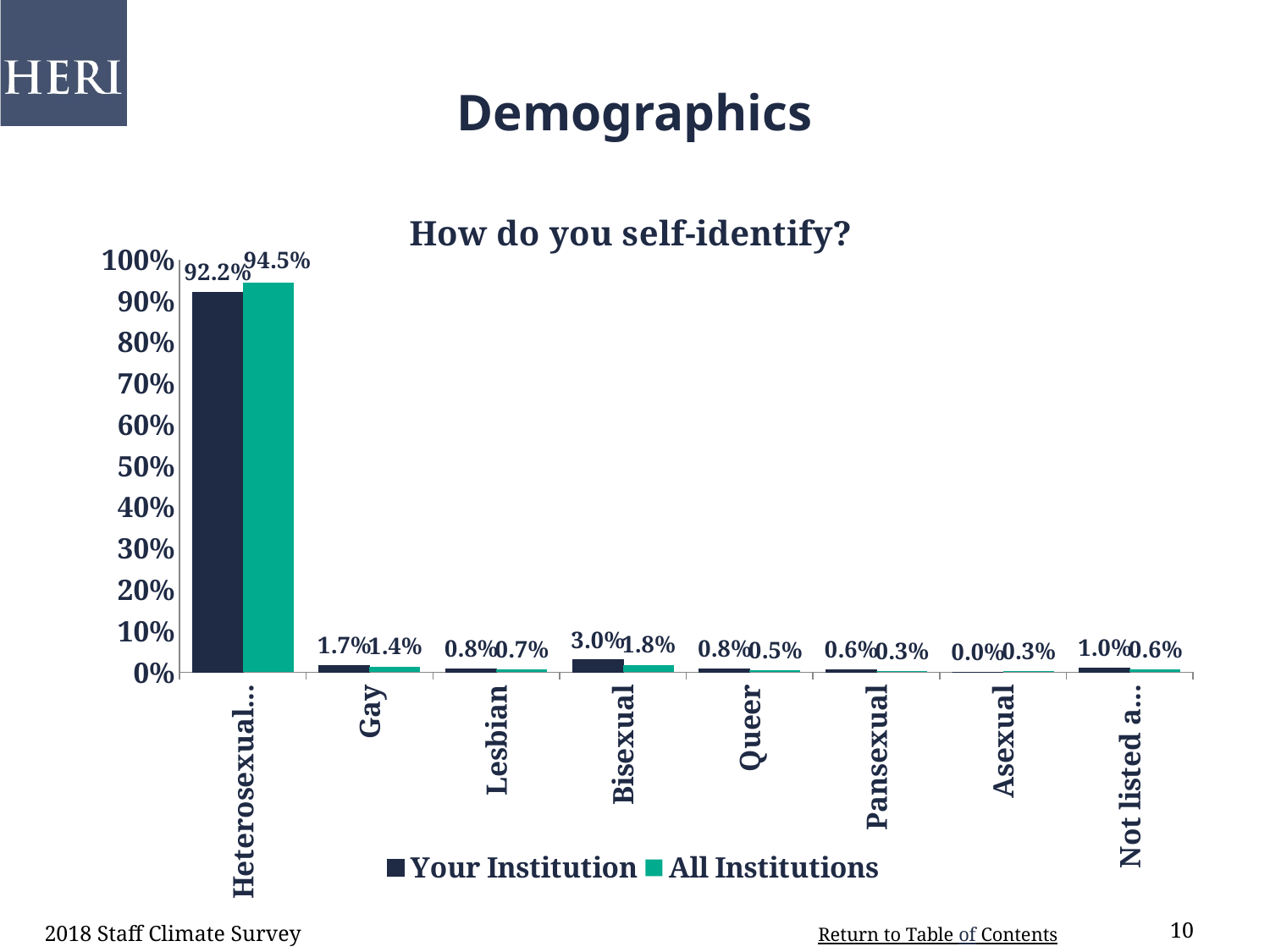
What is the value for Your Institution for Gay? 1.7% Which is larger for Pansexual: Your Institution or All Institutions? Your Institution What is the difference between the All Institutions and Your Institution values for Heterosexual? 2.3% What is the value for Your Institution for Asexual? 0.0% What is the value for All Institutions for Bisexual? 1.8% How many series does the legend list? 2 What is the value for All Institutions for Heterosexual? 94.5% What is the difference between the Your Institution and All Institutions values for Bisexual? 1.2% Which category has the lowest value for Your Institution? Asexual How many categories are shown on the x axis? 8 What type of chart is shown? Bar chart Which category has the highest value for Your Institution? Heterosexual